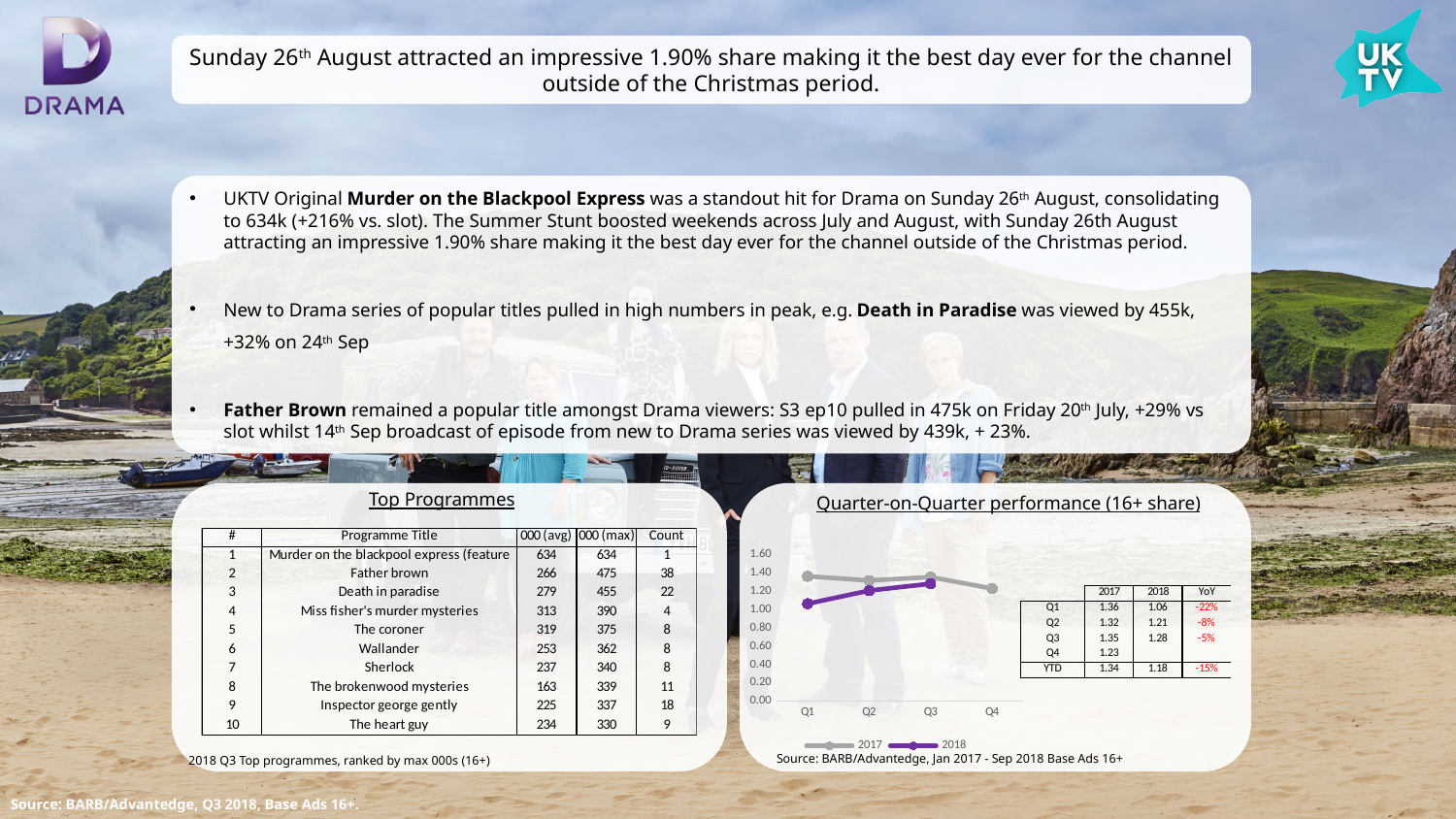
In the Quarter-on-Quarter performance chart, which quarter has the lowest 2018 share? Q1 In the Quarter-on-Quarter performance chart, which quarter has the highest 2018 share? Q3 What kind of chart is the Quarter-on-Quarter performance (16+ share) chart? line chart In the Quarter-on-Quarter performance chart, what is the 2018 share for Q3? 1.28 In the Quarter-on-Quarter performance chart, what is the 2017 share for Q1? 1.36 In the Quarter-on-Quarter performance chart, do the 2018 values rise or fall from Q1 to Q3? rise In the Quarter-on-Quarter performance chart, which quarter has the lowest 2017 share? Q4 In the Quarter-on-Quarter performance chart, what is the 2017 share for Q4? 1.23 How many series does the legend of the Quarter-on-Quarter performance chart list? 2 How many quarters are shown on the x axis of the Quarter-on-Quarter performance chart? 4 In the Quarter-on-Quarter performance chart, what is the difference between the 2017 and 2018 Q1 shares? 0.30 In the Quarter-on-Quarter performance chart, is the Q1 share larger for 2017 or 2018? 2017